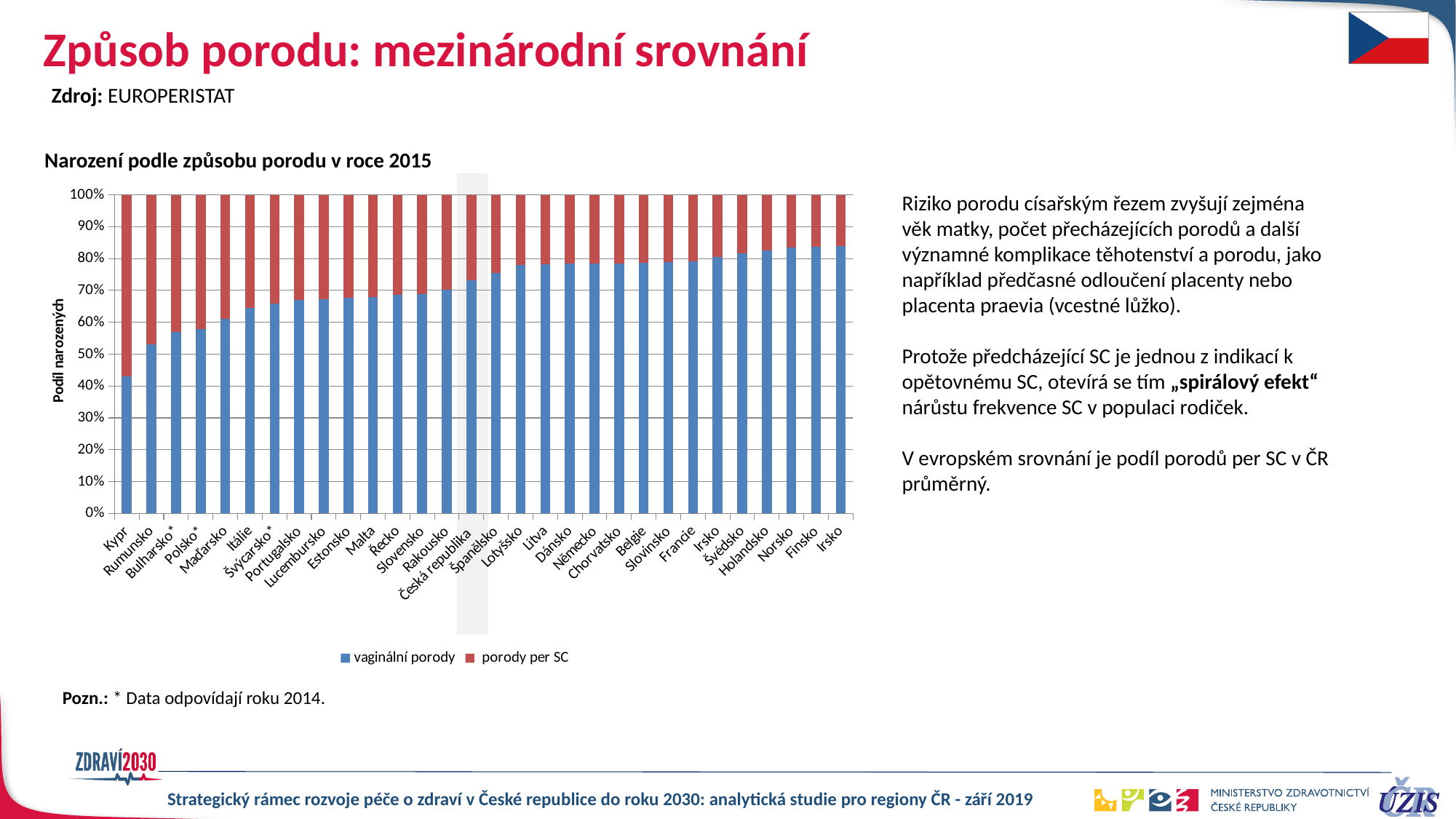
Does the share of vaginální porody rise or fall moving from left to right along the x axis? rise Is the share of vaginální porody for Kypr greater or less than 50%? less What kind of chart is shown on the slide? stacked bar chart What are the two series named in the chart legend? vaginální porody, porody per SC Is the share of vaginální porody for Polsko* greater or less than 60%? less Is the share of vaginální porody for Česká republika greater or less than 70%? greater Which country has the lowest share of vaginální porody? Kypr How many countries are shown on the x axis of the chart? 30 Which has a larger share of vaginální porody, Kypr or Rumunsko? Rumunsko Which country has the highest share of porody per SC? Kypr How many series does the chart legend list? 2